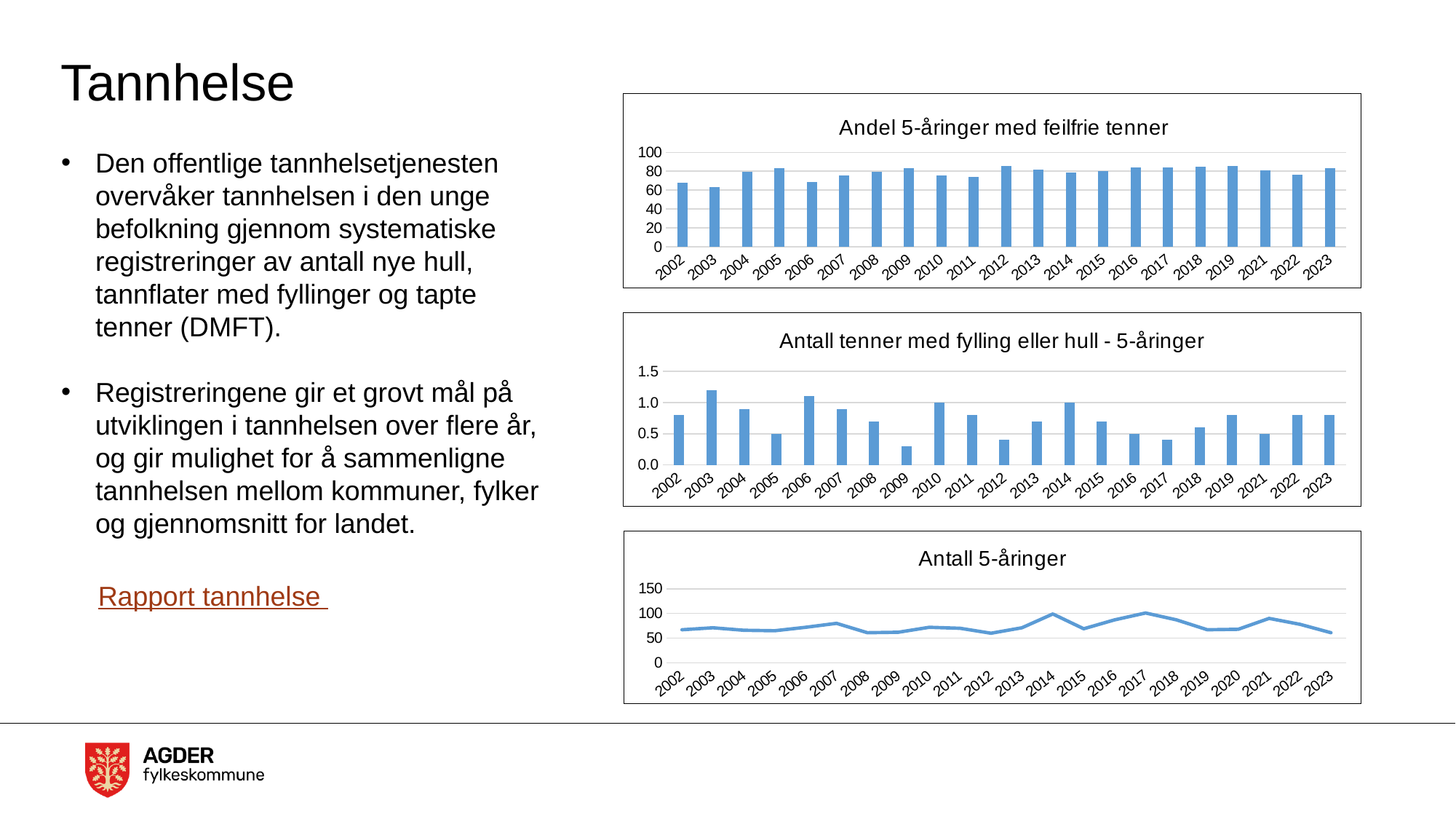
In the 'Andel 5-åringer med feilfrie tenner' chart, is the value for 2003 greater or less than 80? less In the 'Antall tenner med fylling eller hull - 5-åringer' chart, which year has the lowest value? 2009 In the 'Antall tenner med fylling eller hull - 5-åringer' chart, which is larger, the value for 2003 or the value for 2009? 2003 In the 'Andel 5-åringer med feilfrie tenner' chart, which year has the lowest value? 2003 In the 'Antall 5-åringer' chart, is the value for 2014 greater or less than 50? greater In the 'Antall tenner med fylling eller hull - 5-åringer' chart, which year has the highest value? 2003 In the 'Antall tenner med fylling eller hull - 5-åringer' chart, is the value for 2006 greater or less than 1.0? greater In the 'Antall 5-åringer' chart, how many years are shown on the x axis? 22 What kind of chart is the 'Andel 5-åringer med feilfrie tenner' chart? bar chart In the 'Andel 5-åringer med feilfrie tenner' chart, how many years are shown on the x axis? 21 What kind of chart is the 'Antall 5-åringer' chart at the bottom of the slide? line chart